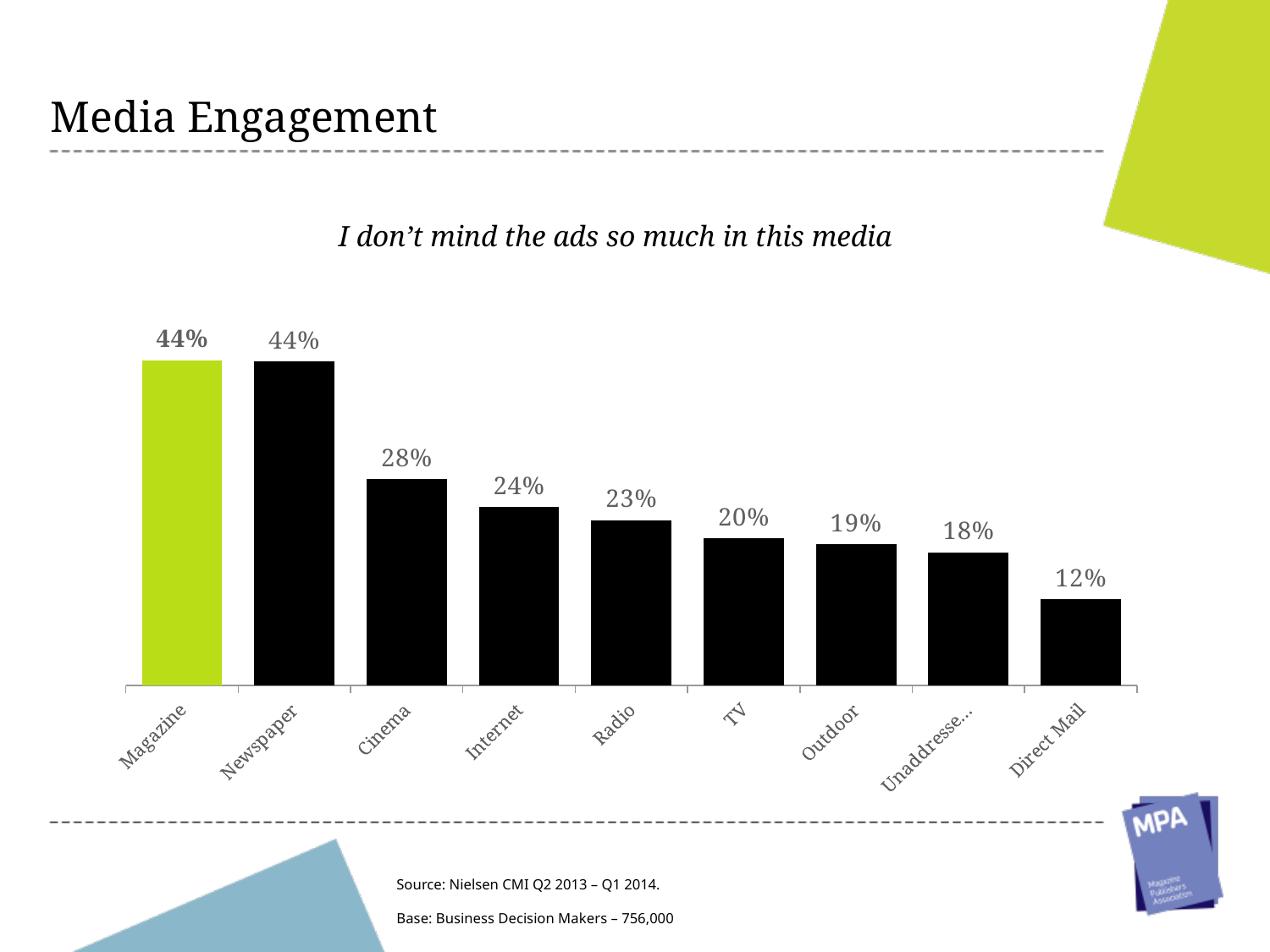
What is the value for Cinema? 28% What kind of chart is shown on the slide? Bar chart Which category has the lowest value? Direct Mail What is the value for Radio? 23% Which is larger, the value for Internet or the value for Cinema? Cinema What is the difference between the values for Cinema and Internet? 4% What is the value for Direct Mail? 12% What is the difference between the values for Newspaper and Direct Mail? 32% Which bar is highlighted in green rather than black? Magazine What is the value for Magazine? 44% How many categories are shown on the chart? 9 Which is larger, the value for TV or the value for Outdoor? TV